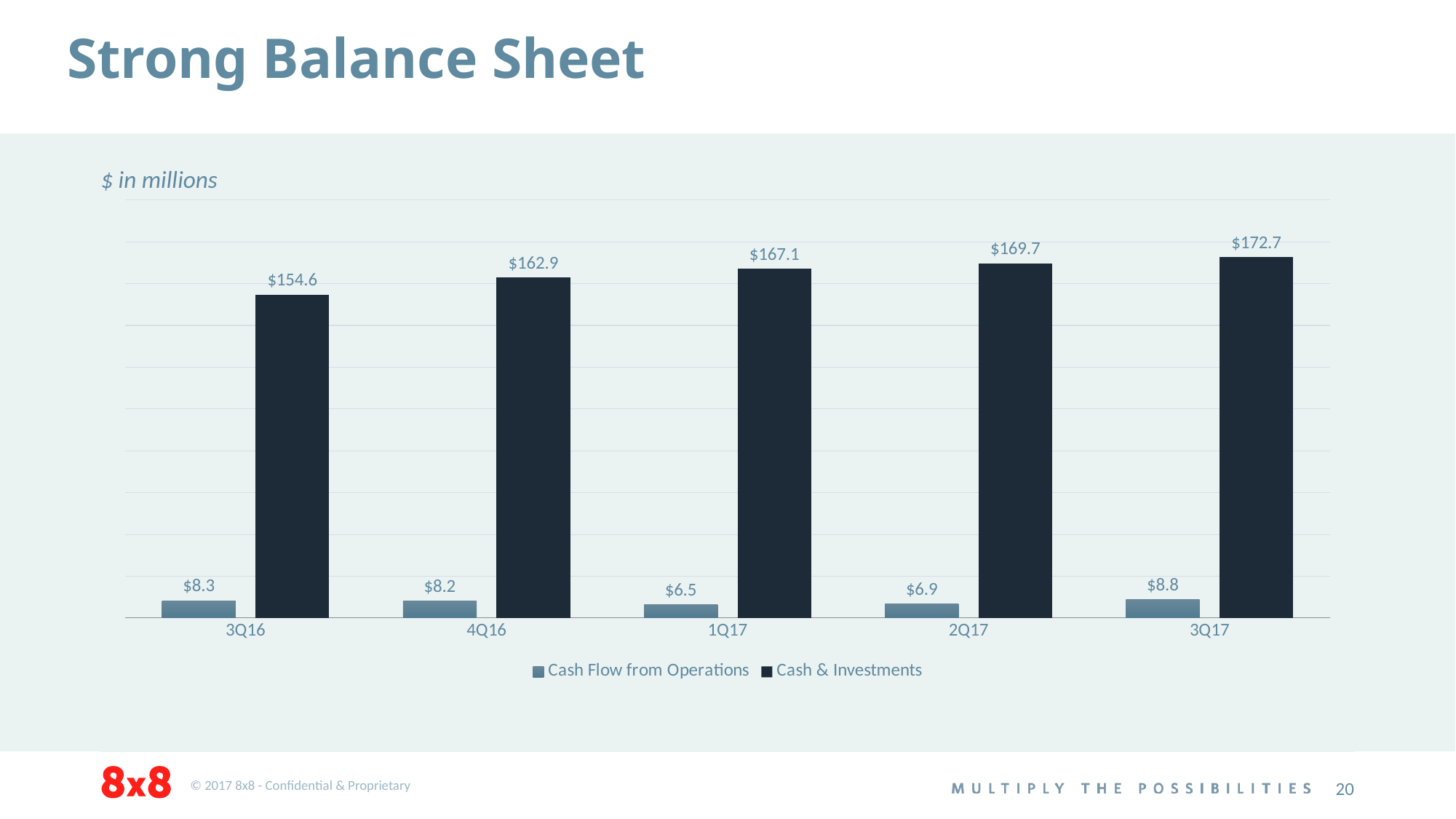
Which quarter has the highest Cash Flow from Operations? 3Q17 What is the Cash & Investments value for 3Q16? $154.6 What is the Cash Flow from Operations value for 1Q17? $6.5 What is the Cash & Investments value for 3Q17? $172.7 How many quarters are shown on the x axis? 5 Which is larger, Cash Flow from Operations in 2Q17 or in 4Q16? 4Q16 What is the difference in Cash & Investments between 3Q17 and 3Q16? $18.1 How many series does the legend list? 2 Do the Cash & Investments values rise or fall from 3Q16 to 3Q17? Rise Which quarter has the lowest Cash Flow from Operations? 1Q17 Which quarter has the lowest Cash & Investments? 3Q16 What kind of chart is shown on the slide? Bar chart